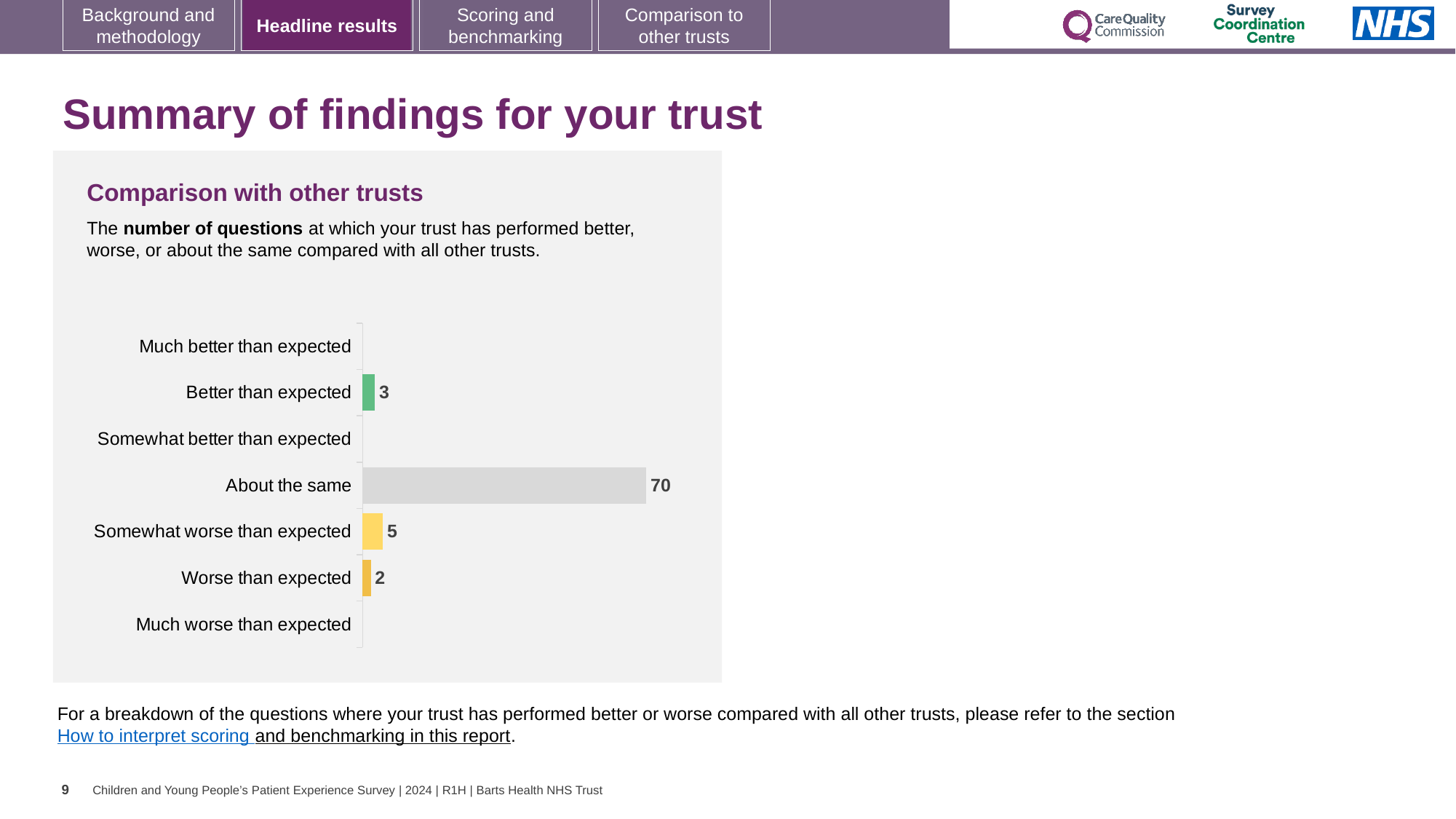
Which category has the highest number of questions? About the same Which is larger, the value for 'Better than expected' or the value for 'Somewhat worse than expected'? Somewhat worse than expected What is the value for 'Worse than expected'? 2 What kind of chart is shown on the slide? Bar chart Which is larger, the value for 'Worse than expected' or the value for 'Better than expected'? Better than expected What is the difference between the values for 'Somewhat worse than expected' and 'Better than expected'? 2 What is the value for 'Somewhat worse than expected'? 5 How many questions were rated 'About the same'? 70 What is the title of the chart? Comparison with other trusts What is the difference between the values for 'About the same' and 'Somewhat worse than expected'? 65 What is the value for 'Better than expected'? 3 How many categories are listed on the chart's axis? 7